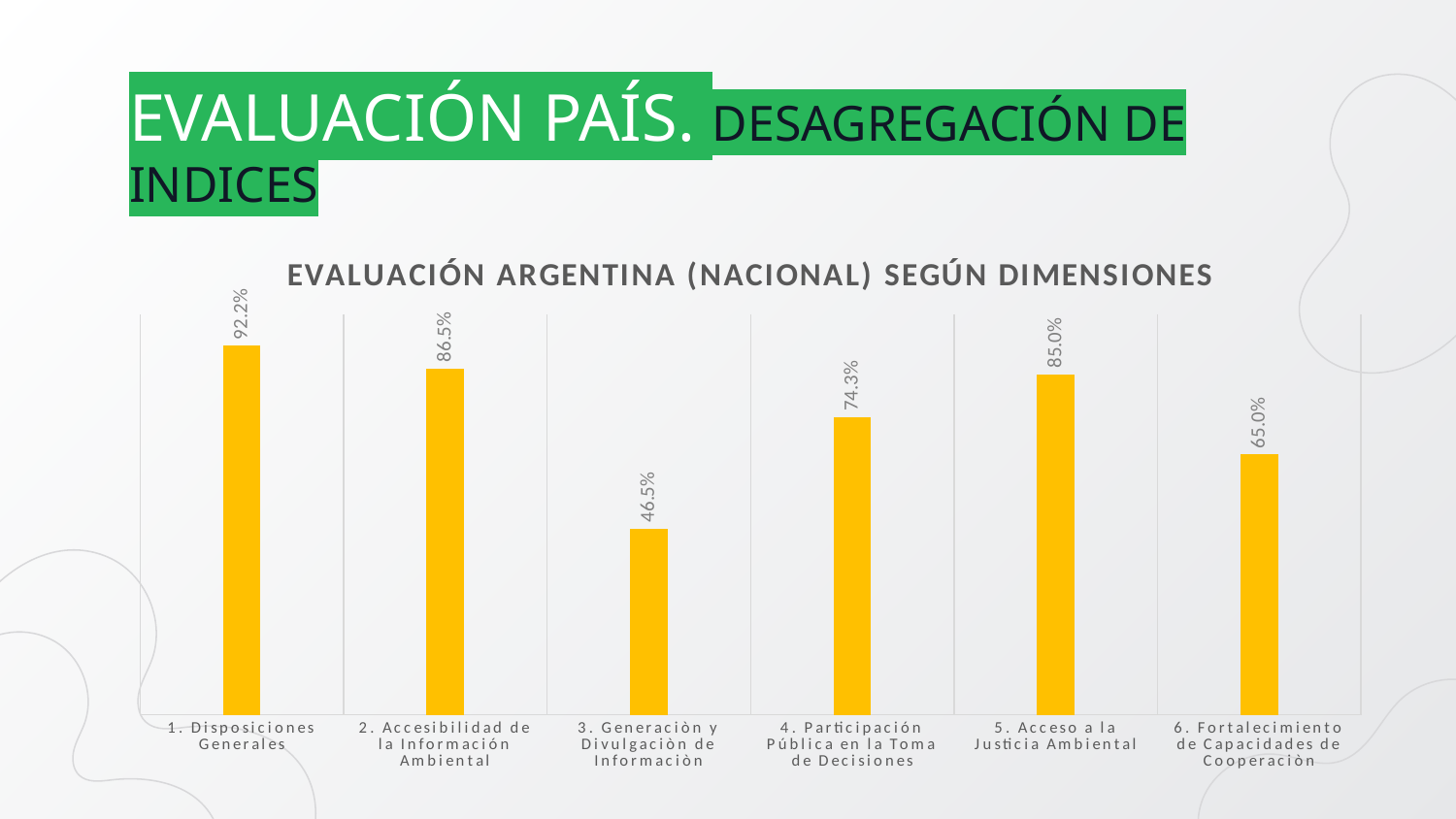
Which dimension has the lowest value? 3. Generaciòn y Divulgaciòn de Informaciòn What is the value for "6. Fortalecimiento de Capacidades de Cooperaciòn"? 65.0% What is the title of the chart? EVALUACIÓN ARGENTINA (NACIONAL) SEGÚN DIMENSIONES What is the difference between the values for "1. Disposiciones Generales" and "2. Accesibilidad de la Información Ambiental"? 5.7% What is the value for "3. Generaciòn y Divulgaciòn de Informaciòn"? 46.5% How many dimensions are shown in the chart? 6 What is the value for "1. Disposiciones Generales"? 92.2% Which is larger, the value for "4. Participación Pública en la Toma de Decisiones" or the value for "5. Acceso a la Justicia Ambiental"? 5. Acceso a la Justicia Ambiental What is the difference between the values for "5. Acceso a la Justicia Ambiental" and "6. Fortalecimiento de Capacidades de Cooperaciòn"? 20.0% What is the value for "5. Acceso a la Justicia Ambiental"? 85.0% Which dimension has the highest value? 1. Disposiciones Generales What kind of chart is shown on the slide? Bar chart